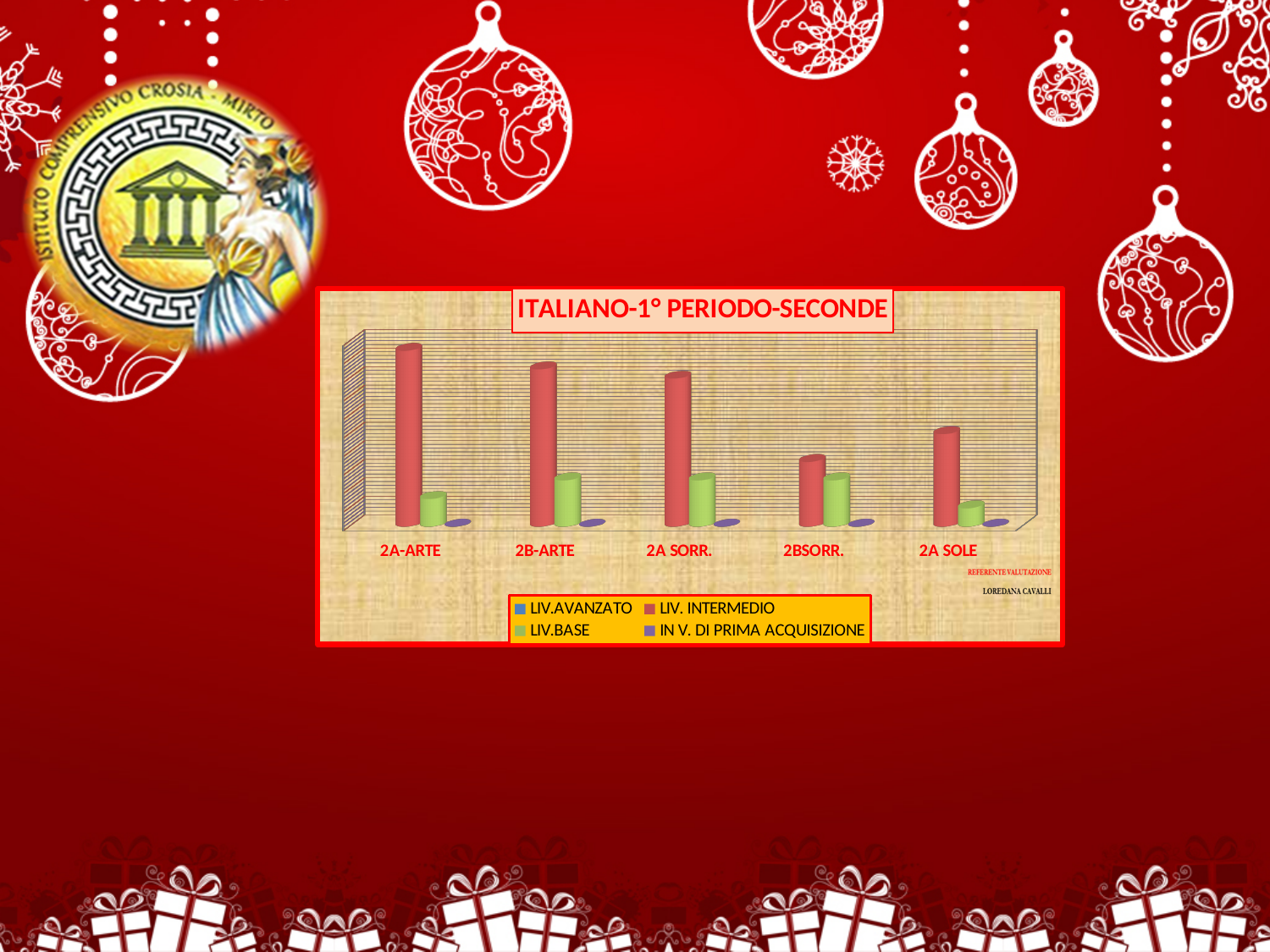
How many series does the chart legend list? 4 Which series is shown in green in the chart legend? LIV.BASE What kind of chart is shown on the slide? bar chart Is the LIV. INTERMEDIO bar larger for 2A-ARTE or for 2A SOLE? 2A-ARTE How many categories are shown on the x axis of the chart? 5 Which category has the lowest LIV.BASE bar? 2A SOLE Is the LIV. INTERMEDIO bar larger for 2BSORR. or for 2A SORR.? 2A SORR. What is the title of the chart? ITALIANO-1° PERIODO-SECONDE Do the LIV. INTERMEDIO bars rise or fall from 2A-ARTE to 2BSORR.? fall Which category has the highest LIV. INTERMEDIO bar? 2A-ARTE For 2BSORR., is the LIV. INTERMEDIO bar or the LIV.BASE bar taller? LIV. INTERMEDIO Which category has the lowest LIV. INTERMEDIO bar? 2BSORR.